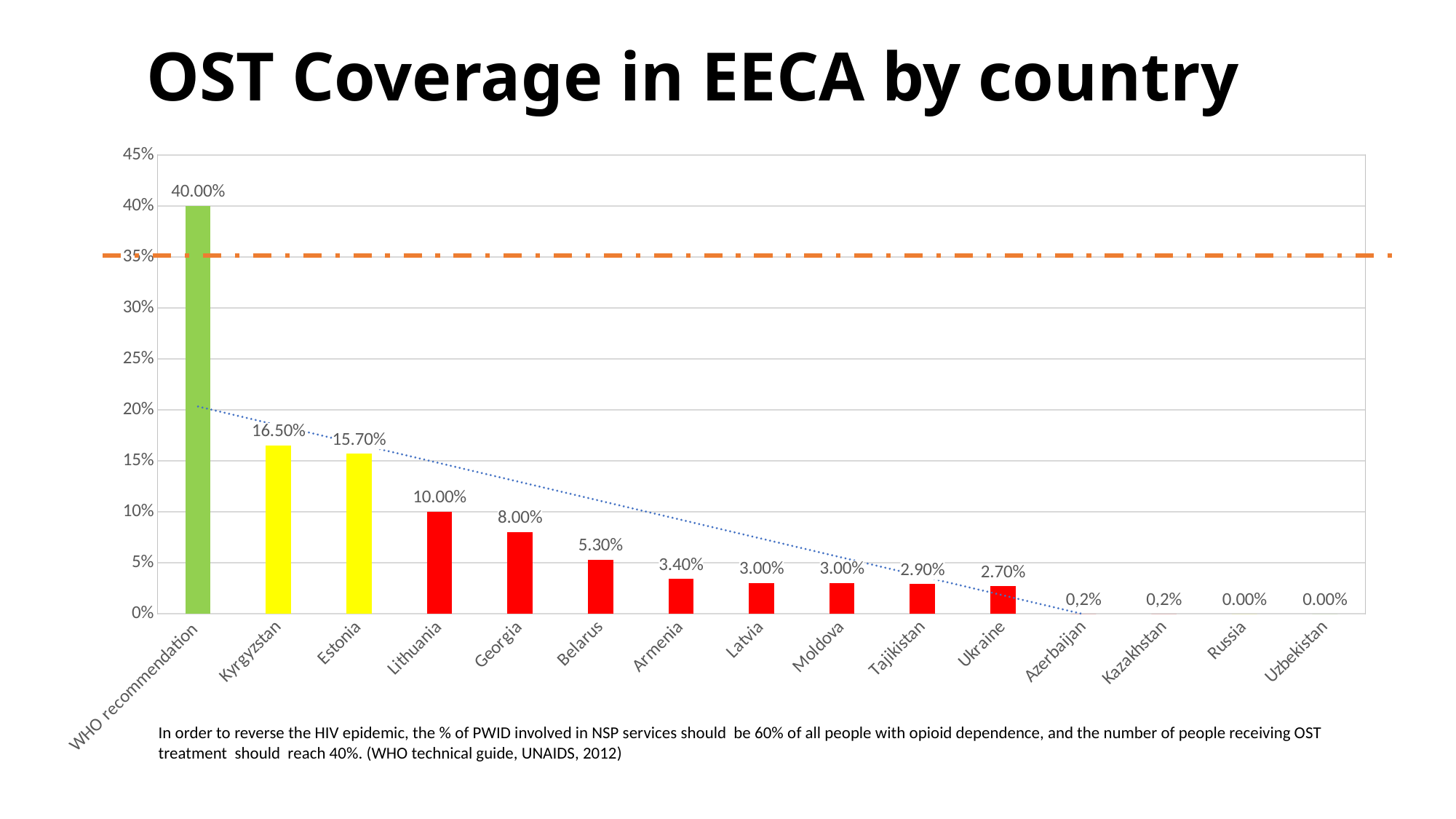
Do the values rise or fall moving from left to right along the x axis? Fall What is the value shown for the WHO recommendation bar? 40.00% What kind of chart is shown on the slide? Bar chart What is the value shown for Kyrgyzstan? 16.50% Which category has the highest value on the chart? WHO recommendation Which country has the highest OST coverage value? Kyrgyzstan What is the value shown for Ukraine? 2.70% What is the value shown for Belarus? 5.30% How many categories are shown on the x axis? 15 What is the value shown for Estonia? 15.70% Which has the larger value, Armenia or Belarus? Belarus What is the difference between the values for Lithuania and Georgia? 2.00%